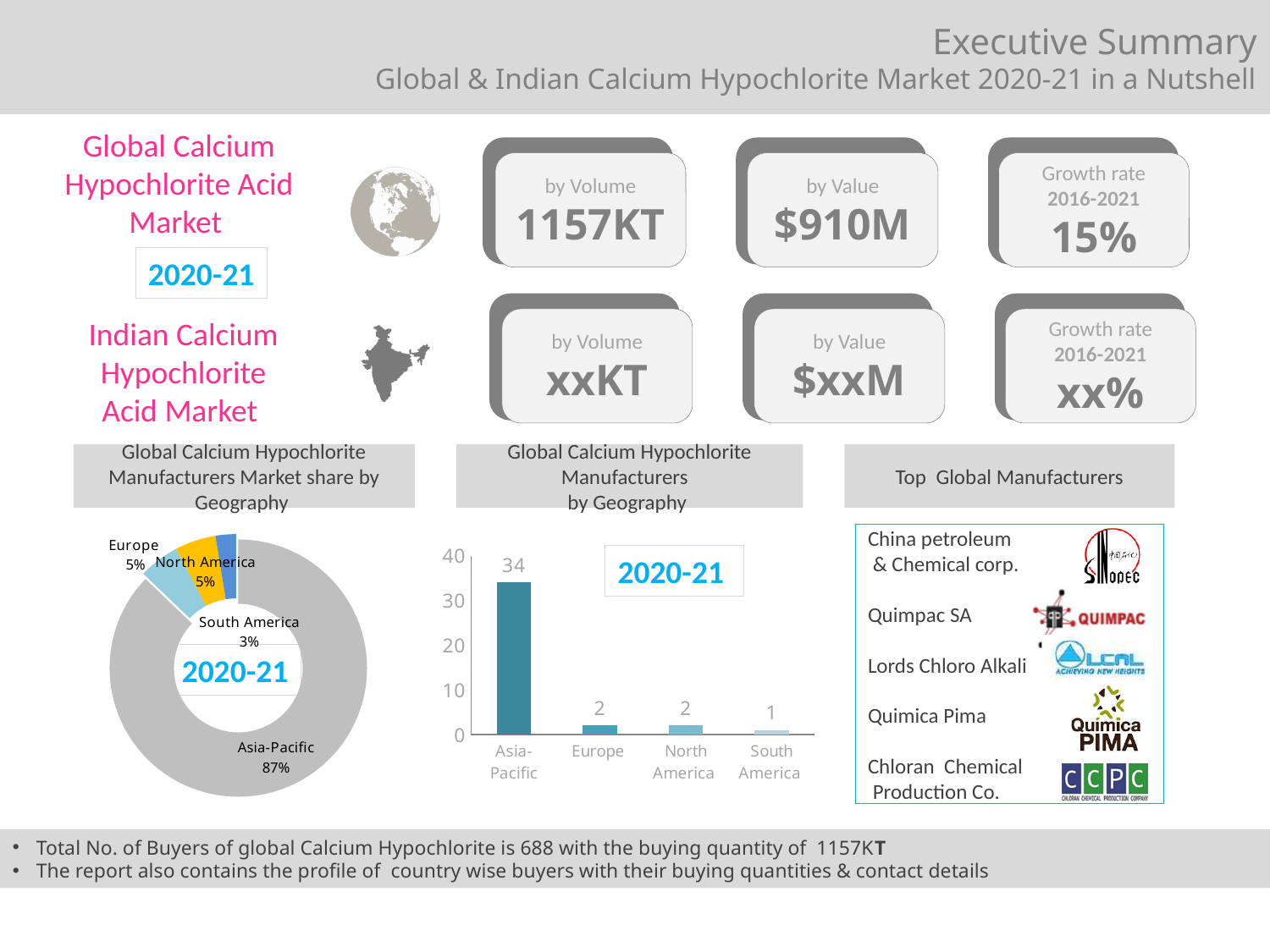
In the 'Global Calcium Hypochlorite Manufacturers by Geography' bar chart, how many manufacturers are in South America? 1 In the 'Global Calcium Hypochlorite Manufacturers by Geography' bar chart, what year label is shown inside the chart area? 2020-21 In the 'Global Calcium Hypochlorite Manufacturers by Geography' bar chart, which region has the most manufacturers? Asia-Pacific In the 'Global Calcium Hypochlorite Manufacturers Market share by Geography' doughnut chart, how many regions are shown? 4 In the 'Global Calcium Hypochlorite Manufacturers Market share by Geography' doughnut chart, what share does South America hold? 3% In the 'Global Calcium Hypochlorite Manufacturers by Geography' bar chart, how many manufacturers are in Asia-Pacific? 34 In the 'Global Calcium Hypochlorite Manufacturers Market share by Geography' doughnut chart, what share does Asia-Pacific hold? 87% In the 'Global Calcium Hypochlorite Manufacturers Market share by Geography' doughnut chart, which region has the smallest share? South America What type of chart is 'Global Calcium Hypochlorite Manufacturers by Geography'? Bar chart In the 'Global Calcium Hypochlorite Manufacturers by Geography' bar chart, what is the difference between the number of manufacturers in Asia-Pacific and Europe? 32 What type of chart is 'Global Calcium Hypochlorite Manufacturers Market share by Geography'? Doughnut chart In the 'Global Calcium Hypochlorite Manufacturers by Geography' bar chart, is the value for Asia-Pacific greater or less than 30? greater